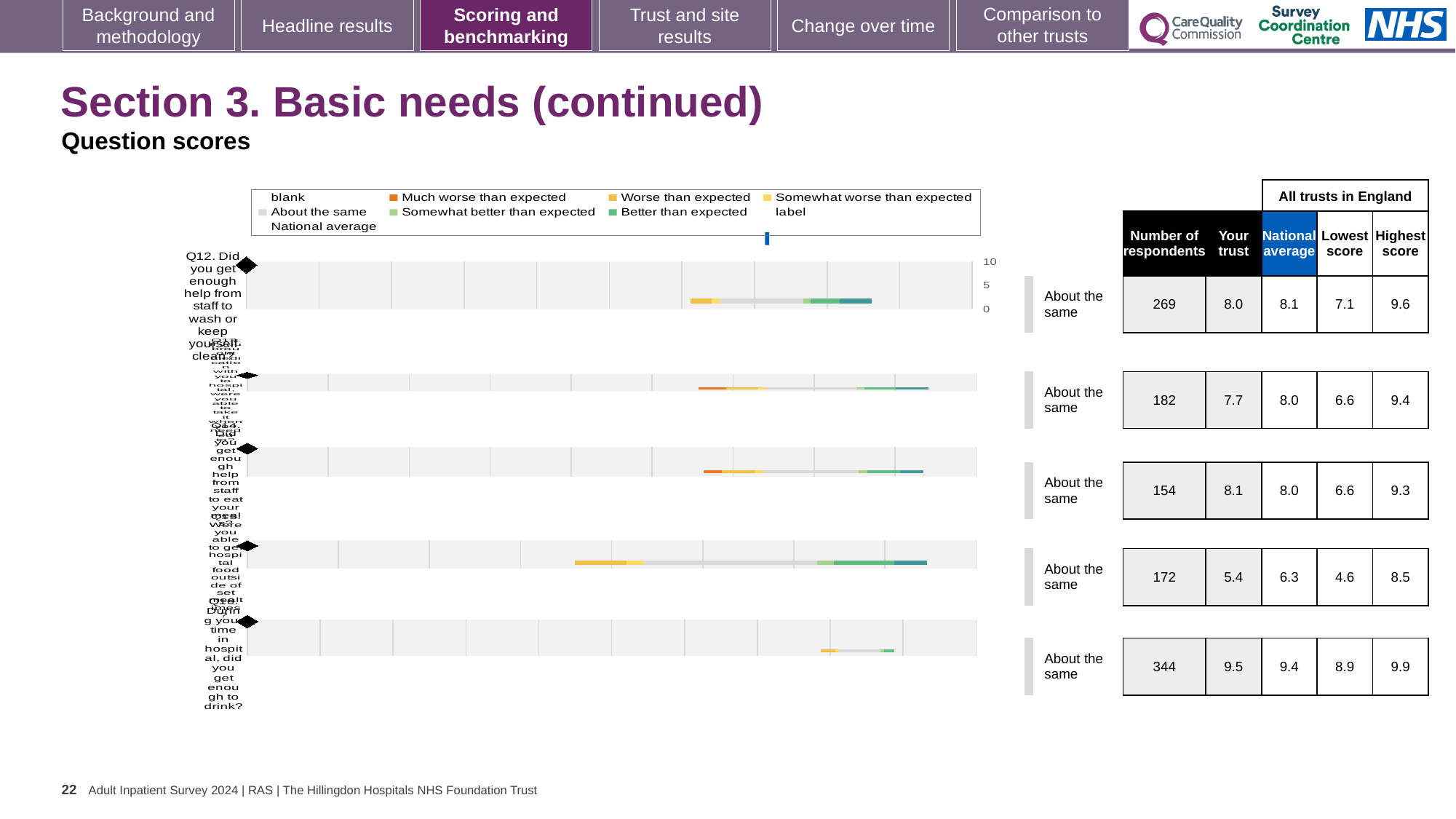
What is the highest score among all trusts in England for Q15? 8.5 What is the lowest score among all trusts in England for the second question row from the top? 6.6 What type of chart is used to show the question scores on this slide? bar chart How many respondents answered Q16 (did you get enough to drink)? 344 What benchmark category is shown for Q15 (hospital food outside of set meal times)? About the same How many questions are plotted in the question scores chart? 5 For Q14 (help from staff to eat your meals), is the 'Your trust' score or the national average larger? Your trust What is the difference between the 'Your trust' score and the national average for Q12? 0.1 Which question has the lowest 'Your trust' score? Q15 What colour does the legend use for 'Much worse than expected'? orange Which question has the highest 'Your trust' score? Q16 What is the 'Your trust' score for Q12 (help from staff to wash or keep yourself clean)? 8.0